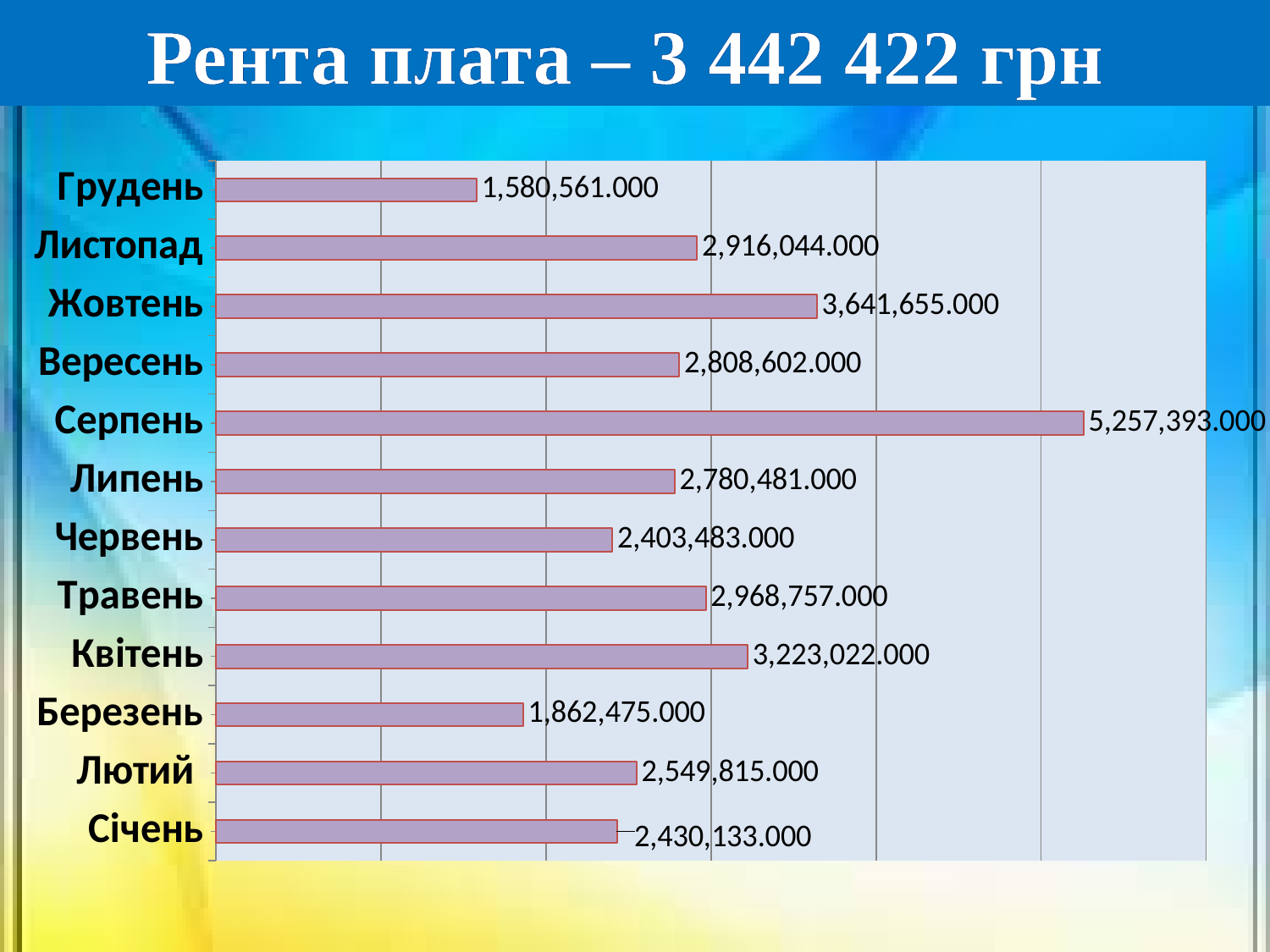
What is the value for Серпень? 5,257,393.000 Which month has the highest value? Серпень What is the value for Грудень? 1,580,561.000 What is the difference between the values for Серпень and Грудень? 3,676,832.000 What is the value for Квітень? 3,223,022.000 What kind of chart is shown on the slide? Bar chart Which month has the lowest value? Грудень How many months are shown in the chart? 12 What is the value for Січень? 2,430,133.000 Which is larger, the value for Жовтень or the value for Квітень? Жовтень What is the difference between the values for Квітень and Травень? 254,265.000 Which is larger, the value for Лютий or the value for Січень? Лютий